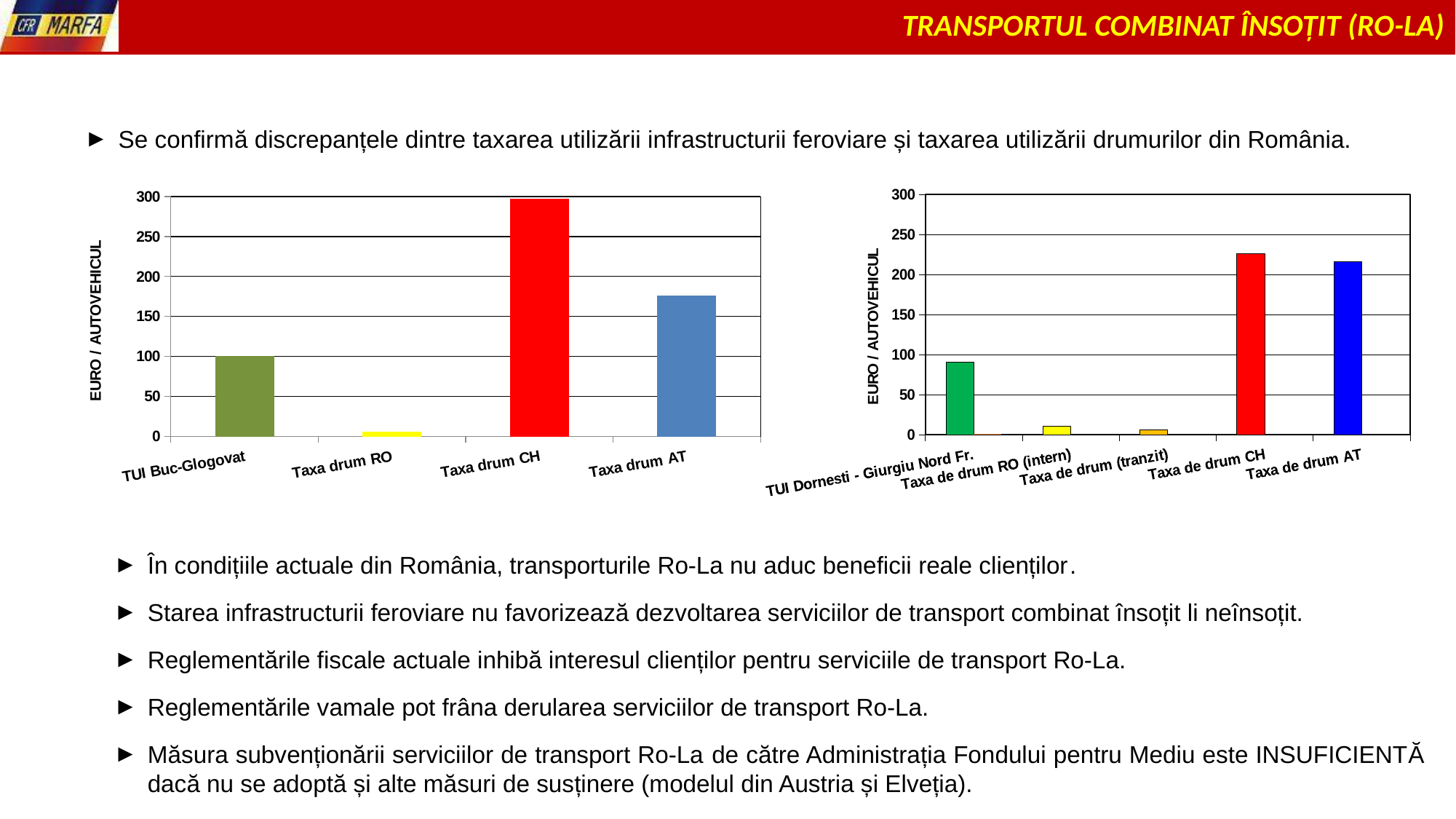
On the right chart, which is larger, TUI Dornesti - Giurgiu Nord Fr. or Taxa de drum RO (intern)? TUI Dornesti - Giurgiu Nord Fr. How many categories are shown on the left chart? 4 On the left chart, which category has the lowest value? Taxa drum RO On the right chart, is the value for Taxa de drum CH greater or less than 200? greater On the left chart, which category has the highest value? Taxa drum CH On the left chart, which is larger, Taxa drum CH or Taxa drum AT? Taxa drum CH What is the y-axis title of the left chart? EURO / AUTOVEHICUL What kind of chart is the left chart? bar chart On the right chart, is the value for Taxa de drum (tranzit) greater or less than 50? less On the left chart, is the value for Taxa drum AT greater or less than 150? greater